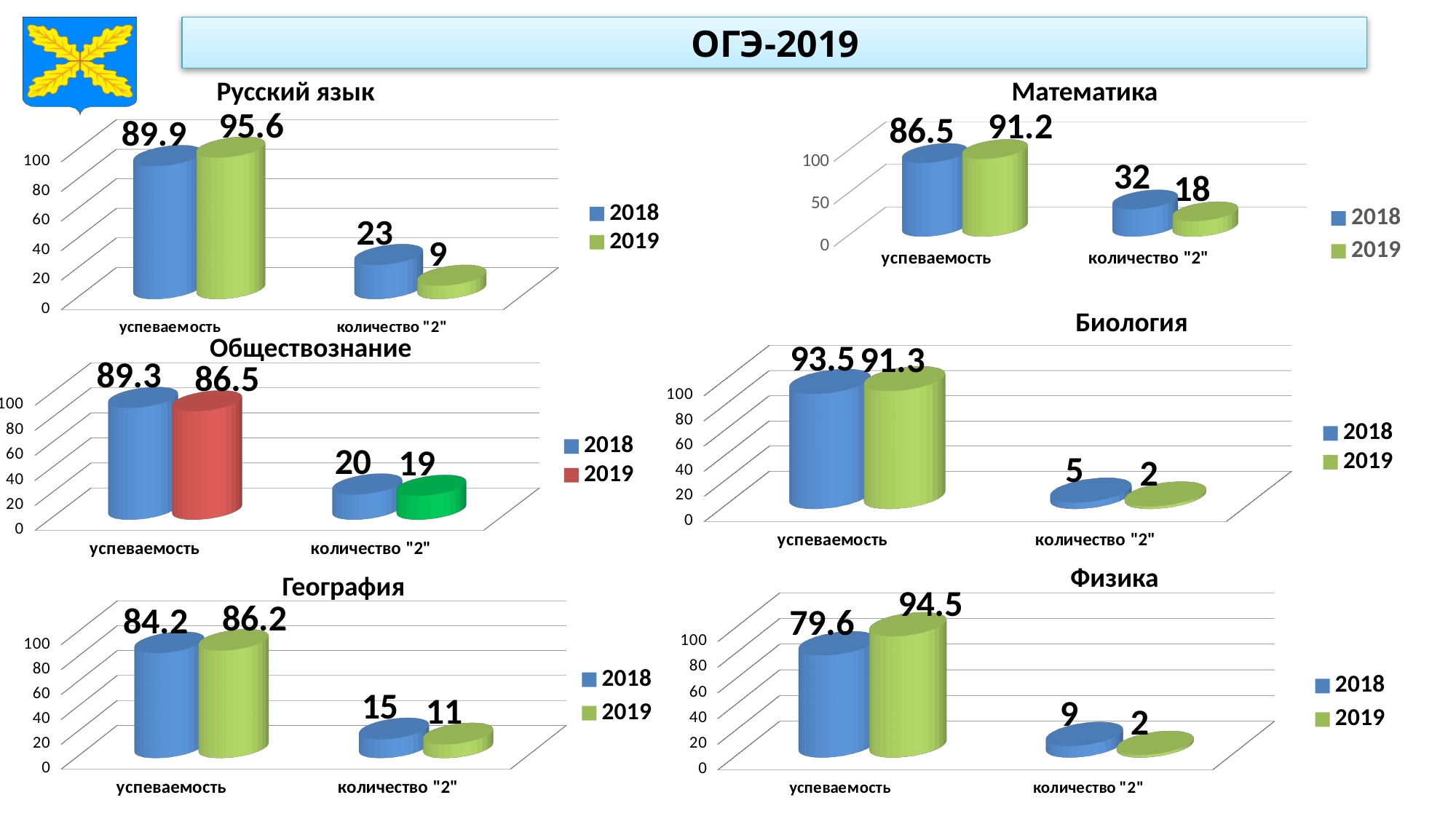
What kind of chart is the "Русский язык" chart? Bar chart In the "География" chart, what is the value for количество "2" in 2019? 11 In the "Математика" chart, which year has the lower количество "2" value, 2018 or 2019? 2019 In the "Обществознание" chart, what is the difference between the успеваемость values for 2018 and 2019? 2.8 How many series does the legend of the "Математика" chart list? 2 In the "Математика" chart, what is the value for количество "2" in 2018? 32 In the "Физика" chart, what is the difference between the успеваемость values for 2019 and 2018? 14.9 In the "Физика" chart, what is the value for количество "2" in 2018? 9 In the "Русский язык" chart, what is the value for успеваемость in 2019? 95.6 How many categories are shown on the x axis of the "Биология" chart? 2 In the "Биология" chart, which year has the higher успеваемость value, 2018 or 2019? 2018 In the "Обществознание" chart, what colour is the 2019 series in the legend? Red